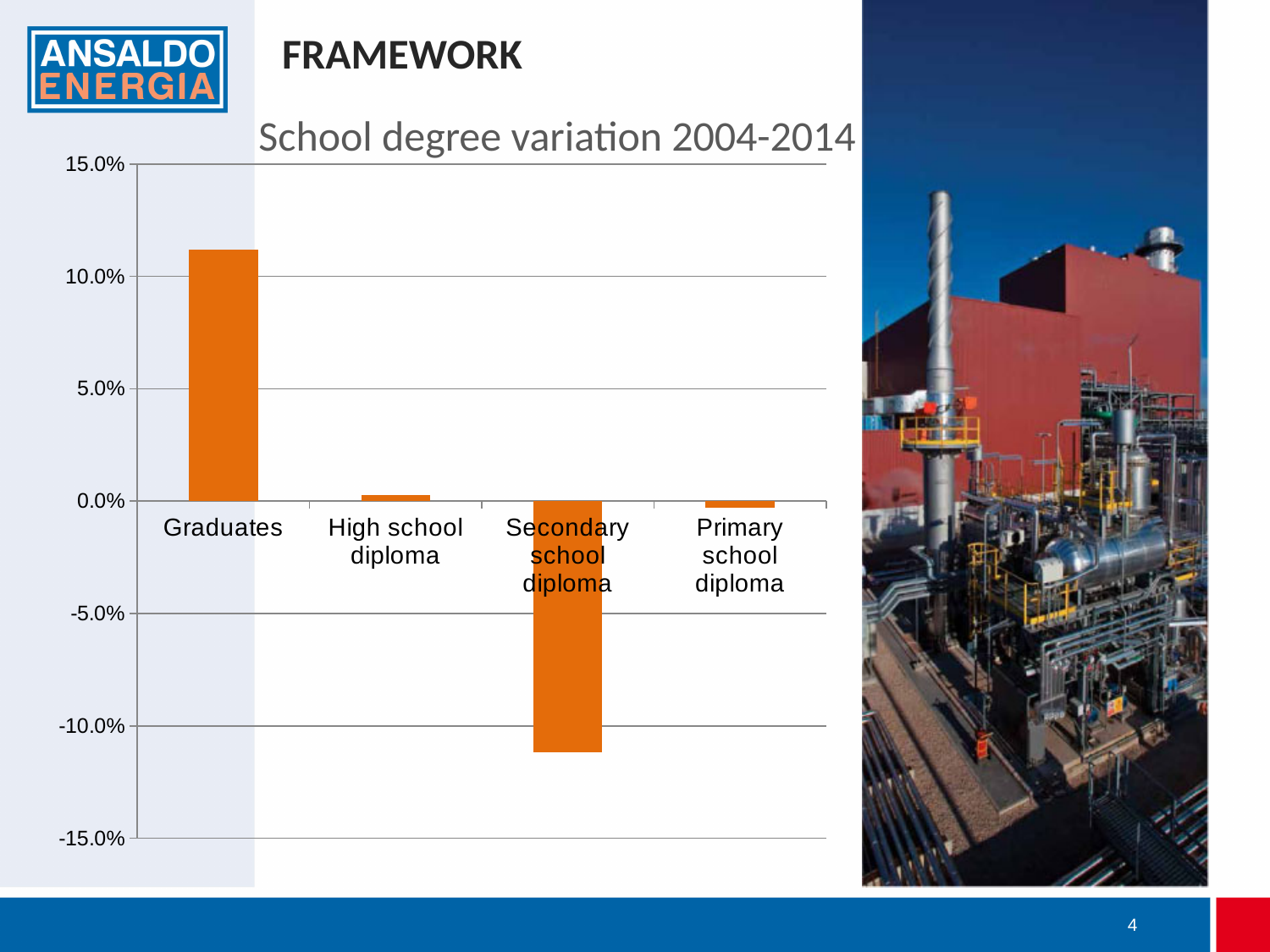
How many categories are plotted in the chart? 4 Which category has the lowest value in the chart? Secondary school diploma What is the title of the chart? School degree variation 2004-2014 How many categories in the chart have a negative value? 2 Which is larger, the value for Graduates or the value for High school diploma? Graduates Which category has the highest value in the chart? Graduates What kind of chart is shown on the slide? Bar chart Is the value for Secondary school diploma greater or less than -10.0%? less Is the value for High school diploma greater or less than 5.0%? less Which is larger, the value for Primary school diploma or the value for Secondary school diploma? Primary school diploma Is the value for Primary school diploma greater or less than 0.0%? less